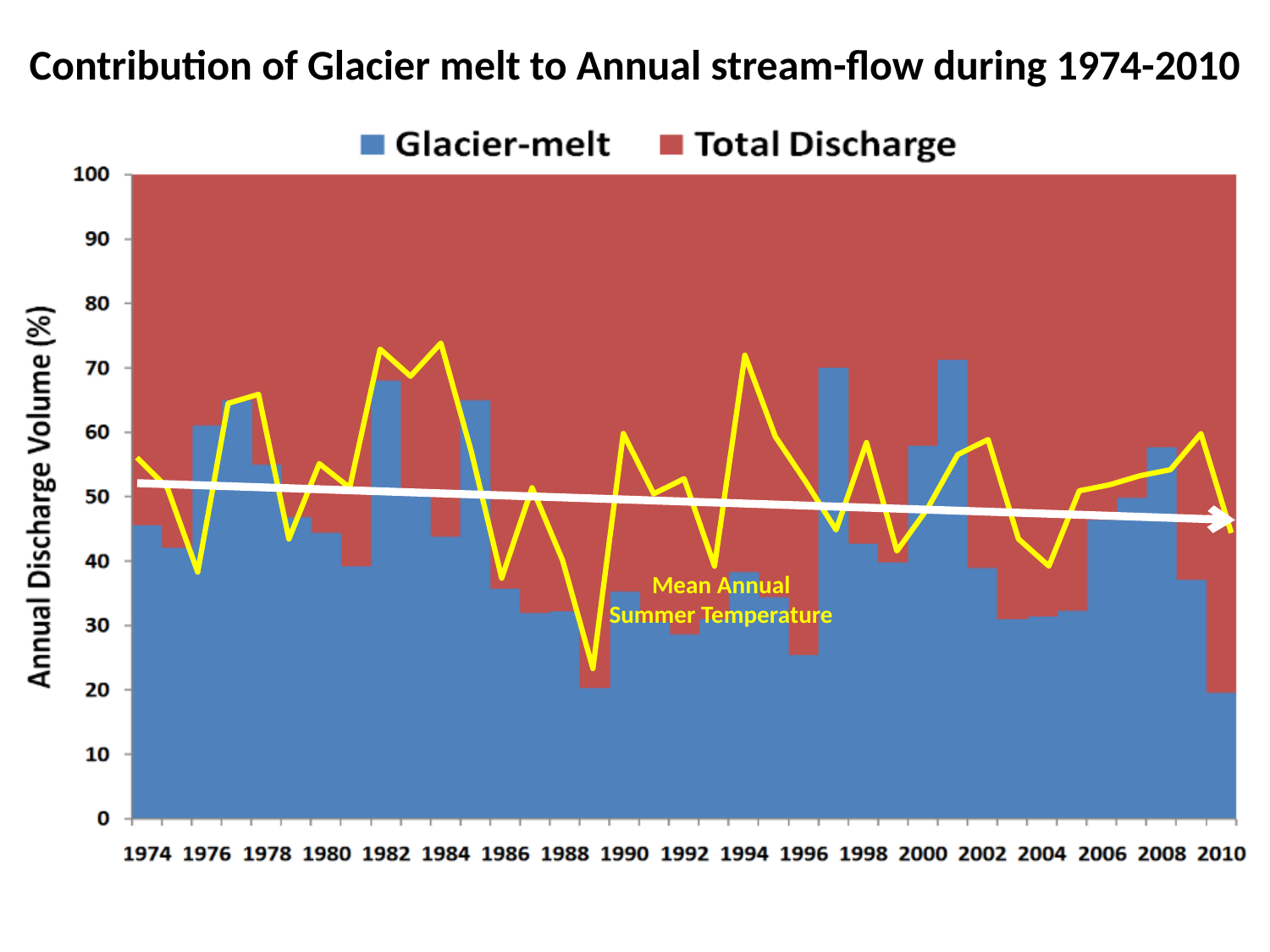
What is the label on the vertical axis? Annual Discharge Volume (%) Is the Glacier-melt value for 1976 greater or less than 50? greater Is the Glacier-melt value for 1974 greater or less than 50? less Which year has the larger Glacier-melt value, 1982 or 1986? 1982 Is the Glacier-melt value for 2010 greater or less than 30? less What kind of chart is shown on the slide? Stacked bar chart How many series does the legend list? 2 Which year has the larger Glacier-melt value, 1989 or 1997? 1997 According to the white trend arrow, does the Glacier-melt contribution rise or fall from 1974 to 2010? Fall What are the two series named in the legend? Glacier-melt and Total Discharge